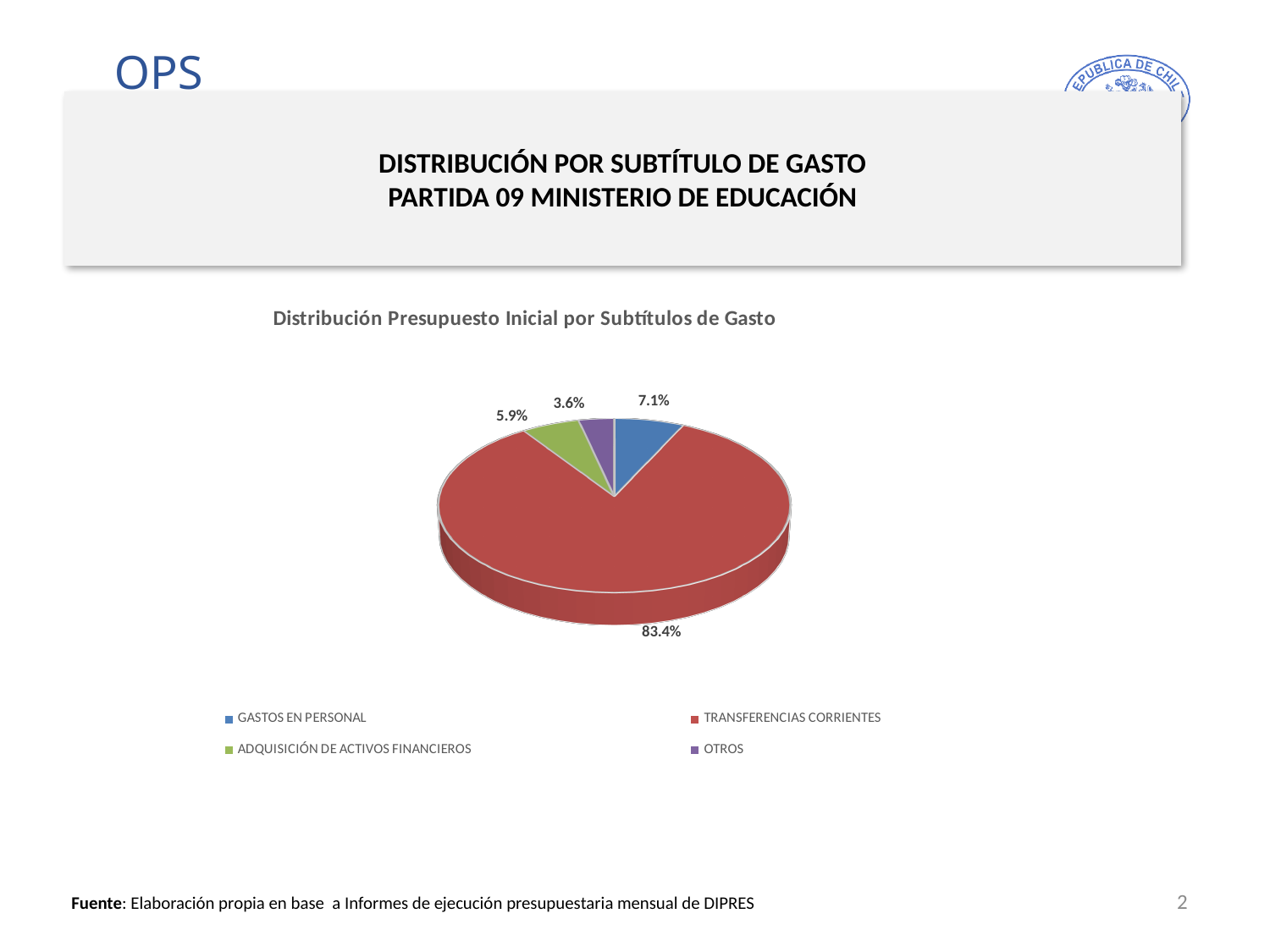
What share of the pie does TRANSFERENCIAS CORRIENTES represent? 83.4% How many categories does the pie chart show? 4 Which is larger, the share for GASTOS EN PERSONAL or the share for ADQUISICIÓN DE ACTIVOS FINANCIEROS? GASTOS EN PERSONAL What is the title of the chart? Distribución Presupuesto Inicial por Subtítulos de Gasto Which category has the smallest slice of the pie? OTROS What kind of chart is shown on the slide? Pie chart What share of the pie does OTROS represent? 3.6% What is the difference in percentage points between the share for TRANSFERENCIAS CORRIENTES and the share for GASTOS EN PERSONAL? 76.3% What share of the pie does ADQUISICIÓN DE ACTIVOS FINANCIEROS represent? 5.9% Which category has the largest slice of the pie? TRANSFERENCIAS CORRIENTES Which colour represents OTROS in the pie chart? Purple